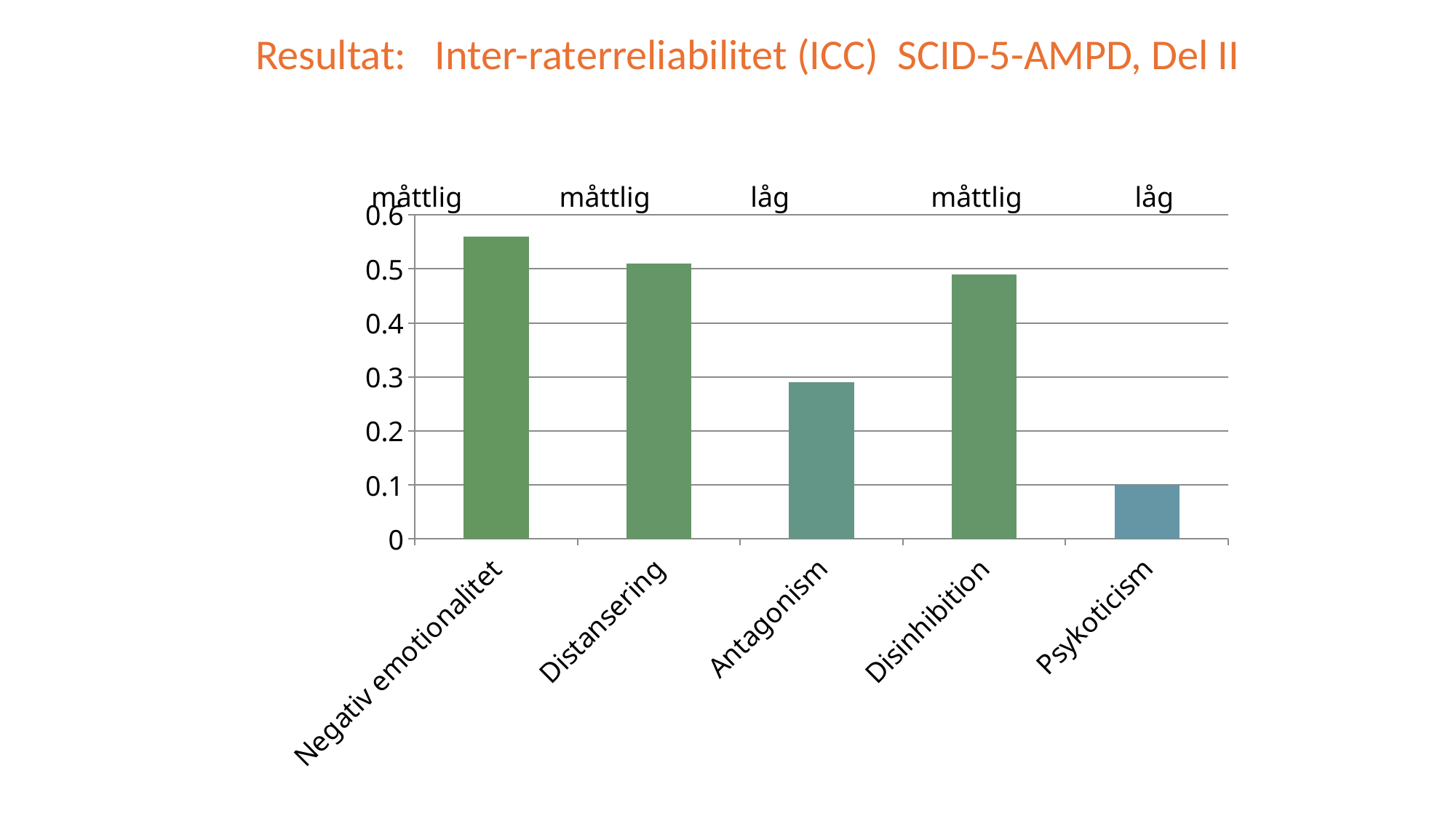
Is the value for Antagonism greater or less than 0.2? greater Is the value for Psykoticism greater or less than 0.2? less Which category has the lowest ICC value in the chart? Psykoticism What is the title of the slide? Resultat: Inter-raterreliabilitet (ICC) SCID-5-AMPD, Del II What is the ICC value for Psykoticism? 0.1 What kind of chart is shown on the slide? bar chart Which has the larger ICC value, Negativ emotionalitet or Antagonism? Negativ emotionalitet How many categories are shown on the x axis of the chart? 5 Which categories are labelled "låg" above their bars? Antagonism and Psykoticism Which category has the highest ICC value in the chart? Negativ emotionalitet Is the value for Disinhibition greater or less than 0.4? greater